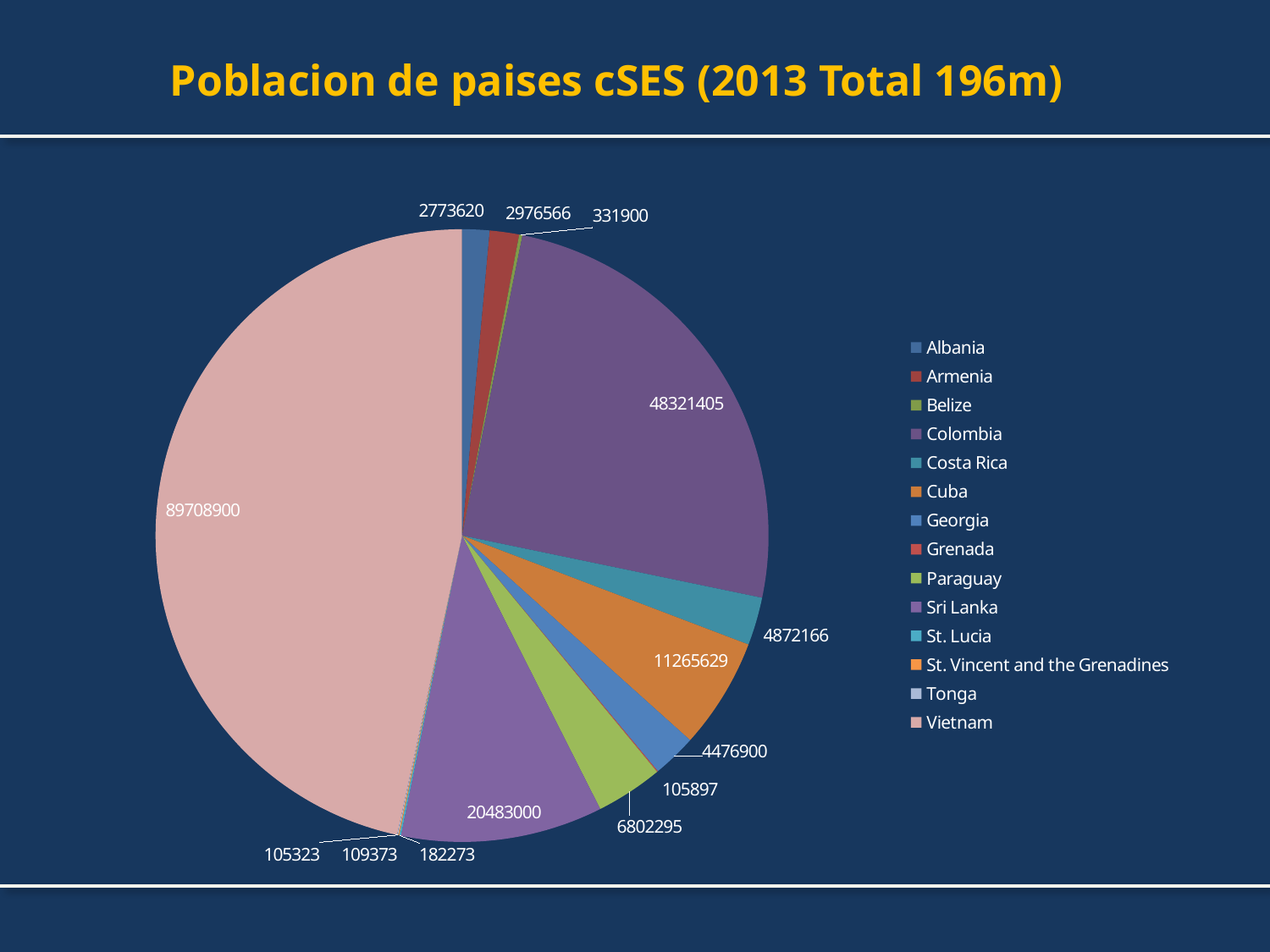
What is the difference between the values for Colombia and Sri Lanka? 27838405 How many countries does the legend list? 14 What is the population value shown for Sri Lanka? 20483000 What kind of chart is shown on the slide? pie chart What is the population value shown for Vietnam? 89708900 What is the population value shown for Cuba? 11265629 Which country has the largest slice of the pie? Vietnam Which country has the smallest value shown on the chart? Tonga What is the population value shown for Paraguay? 6802295 What is the population value shown for Colombia? 48321405 Which has the larger value, Costa Rica or Georgia? Costa Rica What is the title of the chart? Poblacion de paises cSES (2013 Total 196m)